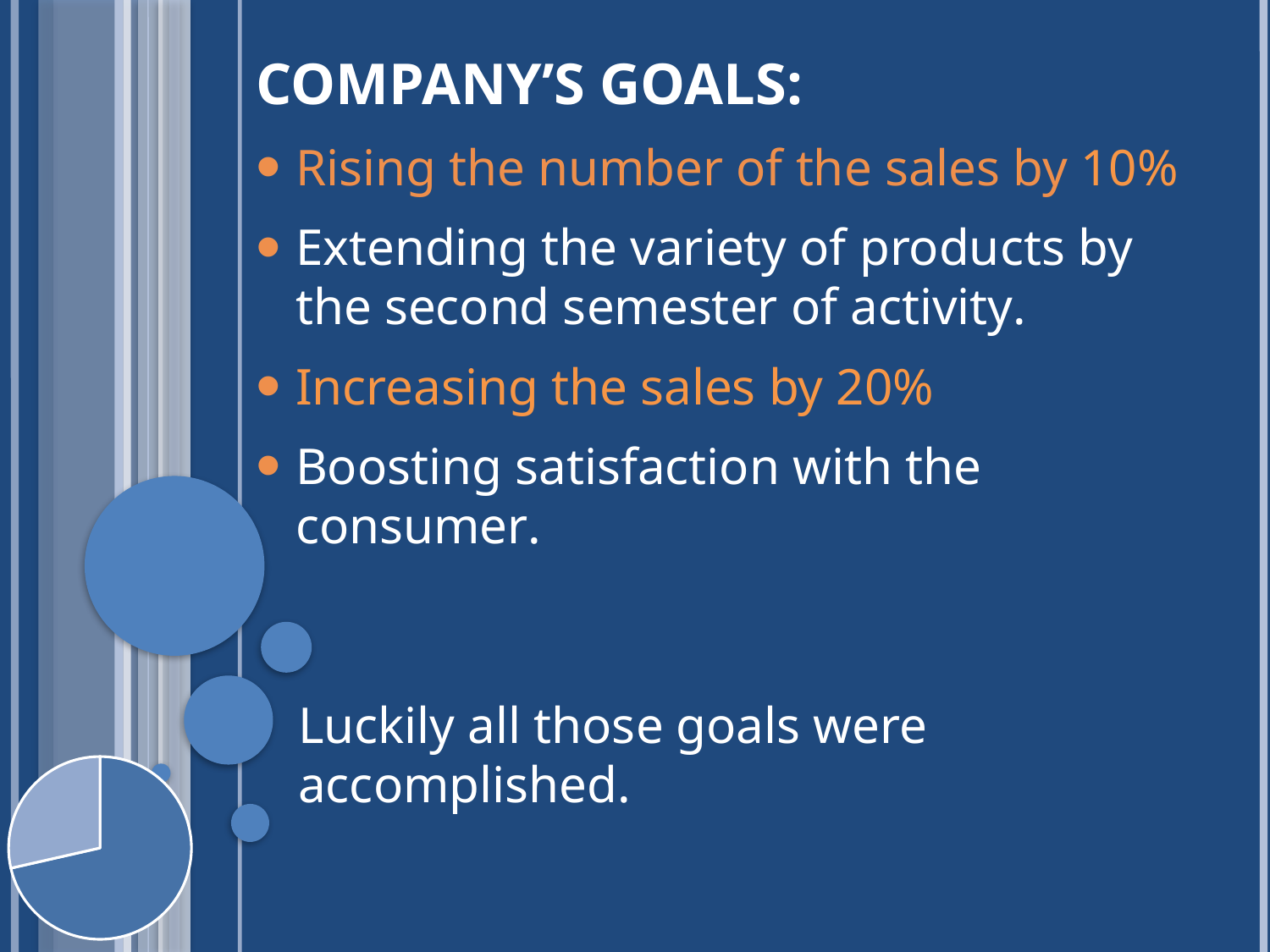
Does the pie chart in the bottom-left corner show any data labels or a legend? No How many slices does the pie chart in the bottom-left corner have? 2 In the pie chart in the bottom-left corner, which slice is larger, the darker blue one or the lighter blue one? the darker blue one What kind of chart is shown in the bottom-left corner of the slide? pie chart